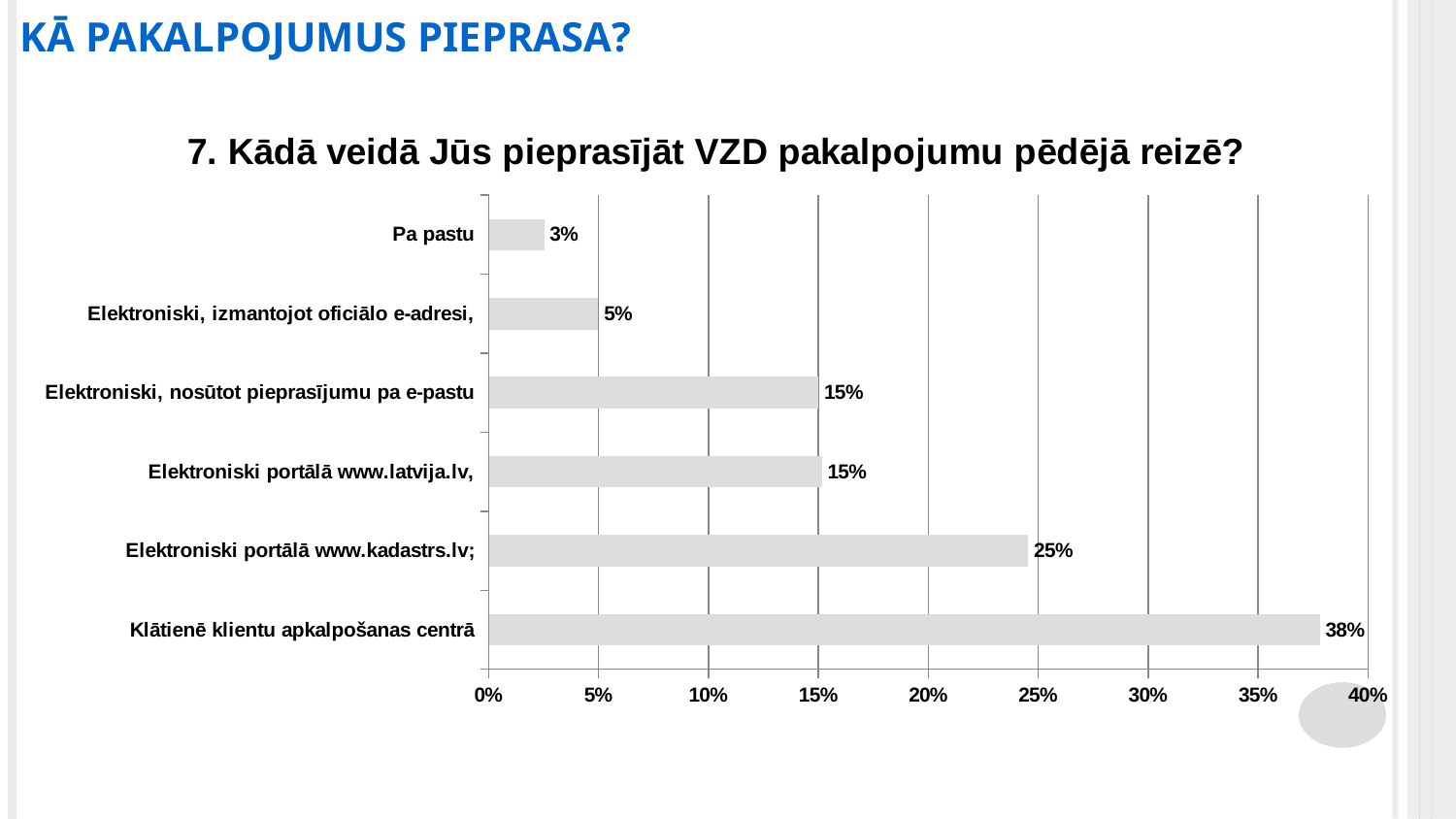
What is the difference between the values for "Klātienē klientu apkalpošanas centrā" and "Elektroniski portālā www.kadastrs.lv;"? 13% How many categories are shown in the chart? 6 Which category has the lowest value? Pa pastu What kind of chart is shown on the slide? bar chart What is the value for "Elektroniski portālā www.kadastrs.lv;"? 25% What is the value for "Klātienē klientu apkalpošanas centrā"? 38% Which is larger: the value for "Elektroniski portālā www.kadastrs.lv;" or the value for "Elektroniski portālā www.latvija.lv,"? Elektroniski portālā www.kadastrs.lv; Is the value for "Elektroniski, nosūtot pieprasījumu pa e-pastu" greater or less than 10%? greater What is the value for "Pa pastu"? 3% What is the title of the chart? 7. Kādā veidā Jūs pieprasījāt VZD pakalpojumu pēdējā reizē? Which category has the highest value? Klātienē klientu apkalpošanas centrā What is the value for "Elektroniski, izmantojot oficiālo e-adresi,"? 5%